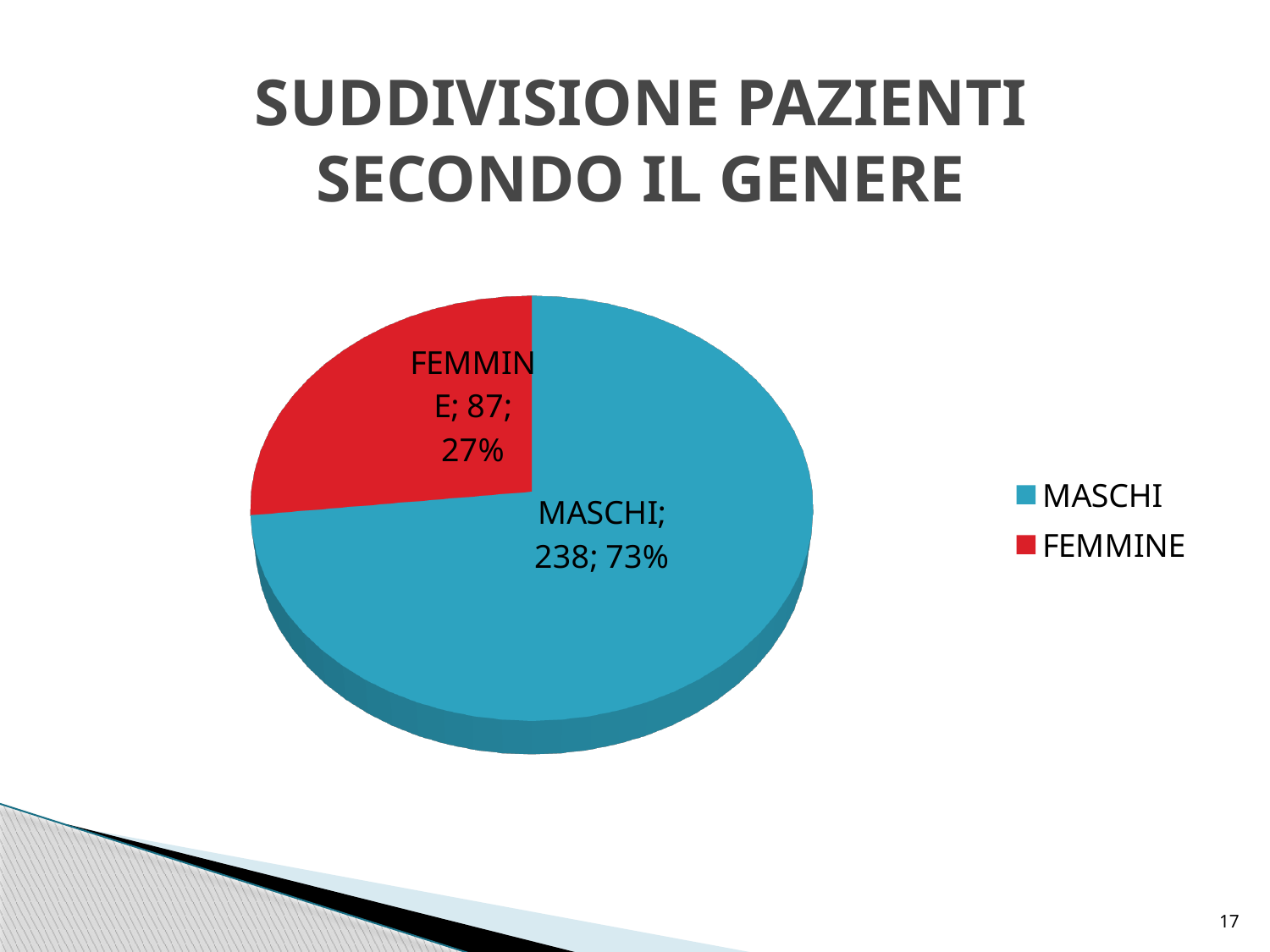
What is the value for MASCHI? 238 What colour is the FEMMINE slice? red What type of chart is shown on the slide? pie chart What share of the pie does the FEMMINE slice represent? 27% What is the difference between the MASCHI and FEMMINE values? 151 What share of the pie does the MASCHI slice represent? 73% What is the total of the two slices? 325 How many categories does the pie chart have? 2 What is the value for FEMMINE? 87 Which category has the largest slice? MASCHI Which category has the smallest slice? FEMMINE Which is larger, the value for MASCHI or the value for FEMMINE? MASCHI